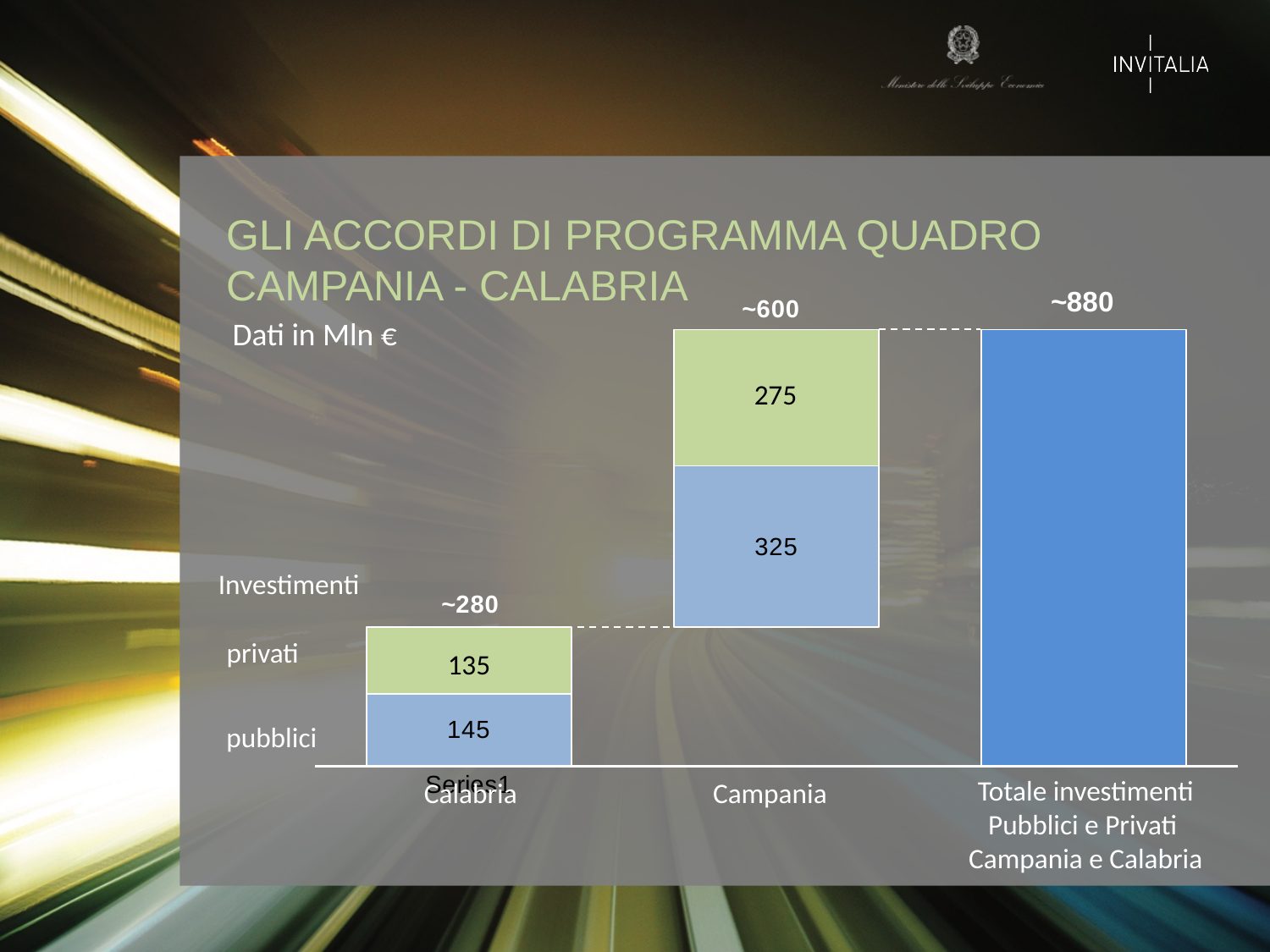
What is the total of the stacked bar for Campania (pubblici plus privati)? 600 What kind of chart is shown on the slide? stacked bar chart What is the total of the stacked bar for Calabria (pubblici plus privati)? 280 What is the value of pubblici investments for Campania? 325 What is the value of privati investments for Calabria? 135 Which is larger for Campania: pubblici or privati investments? pubblici What is the value of pubblici investments for Calabria? 145 What is the value of privati investments for Campania? 275 In what unit are the data on the chart expressed? Mln € Which region has the higher privati investment value, Calabria or Campania? Campania Which colour represents privati investments in the chart? green What is the difference between pubblici investments in Campania and in Calabria? 180